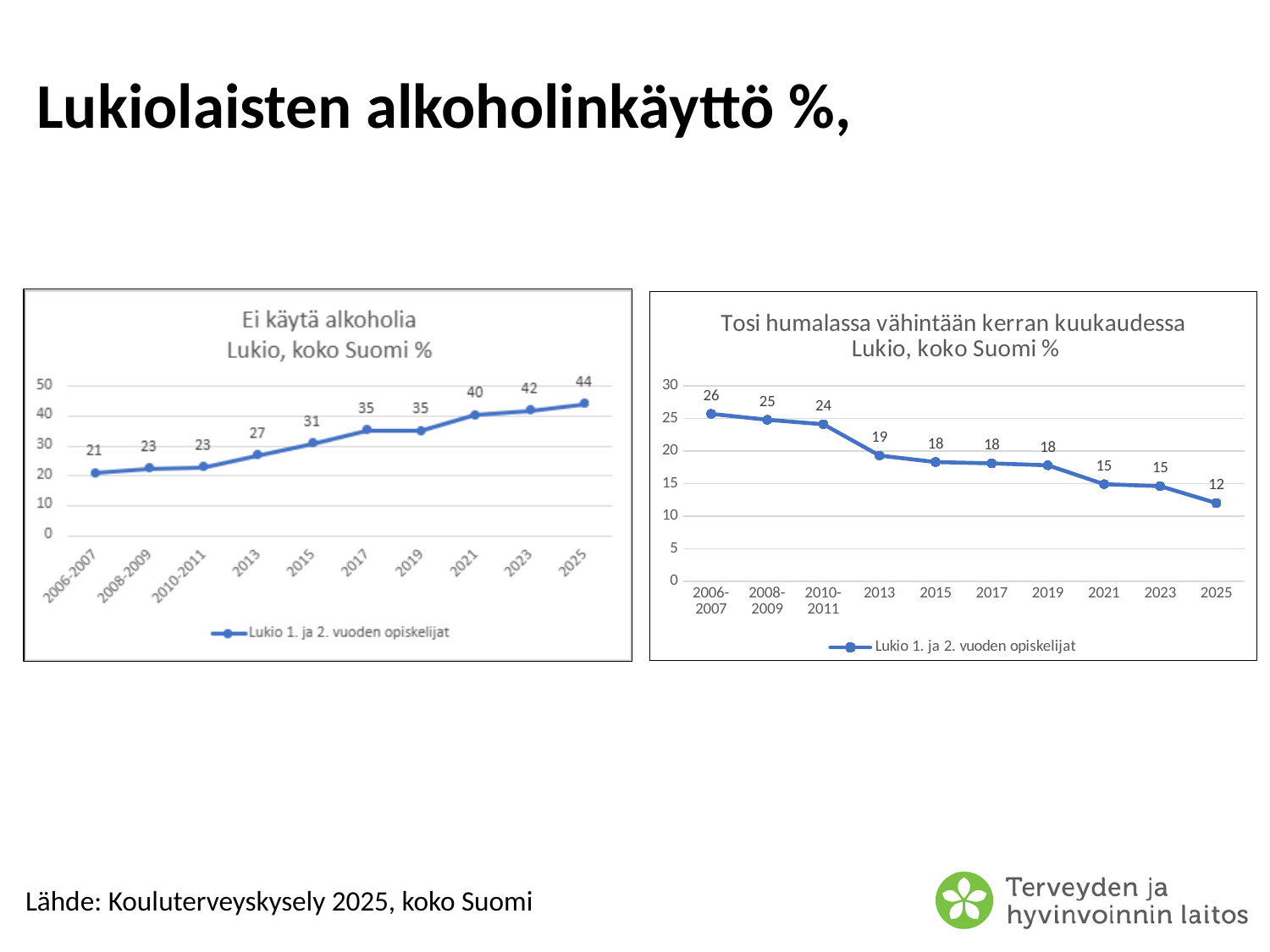
What kind of chart is the 'Ei käytä alkoholia' chart? Line chart In the 'Tosi humalassa vähintään kerran kuukaudessa' chart, do the values generally rise or fall over time? Fall In the 'Ei käytä alkoholia' chart, what is the value for 2025? 44 In the 'Ei käytä alkoholia' chart, which is larger, the value for 2013 or the value for 2021? 2021 How many data points are plotted in the 'Tosi humalassa vähintään kerran kuukaudessa' chart? 10 In the 'Tosi humalassa vähintään kerran kuukaudessa' chart, what is the difference between the values for 2006-2007 and 2025? 14 In the 'Ei käytä alkoholia' chart, what is the difference between the values for 2025 and 2006-2007? 23 How many series does the legend of the 'Ei käytä alkoholia' chart list? 1 In the 'Ei käytä alkoholia' chart, what is the value for 2006-2007? 21 In the 'Tosi humalassa vähintään kerran kuukaudessa' chart, which year has the lowest value? 2025 In the 'Ei käytä alkoholia' chart, which year has the highest value? 2025 In the 'Tosi humalassa vähintään kerran kuukaudessa' chart, what is the value for 2013? 19